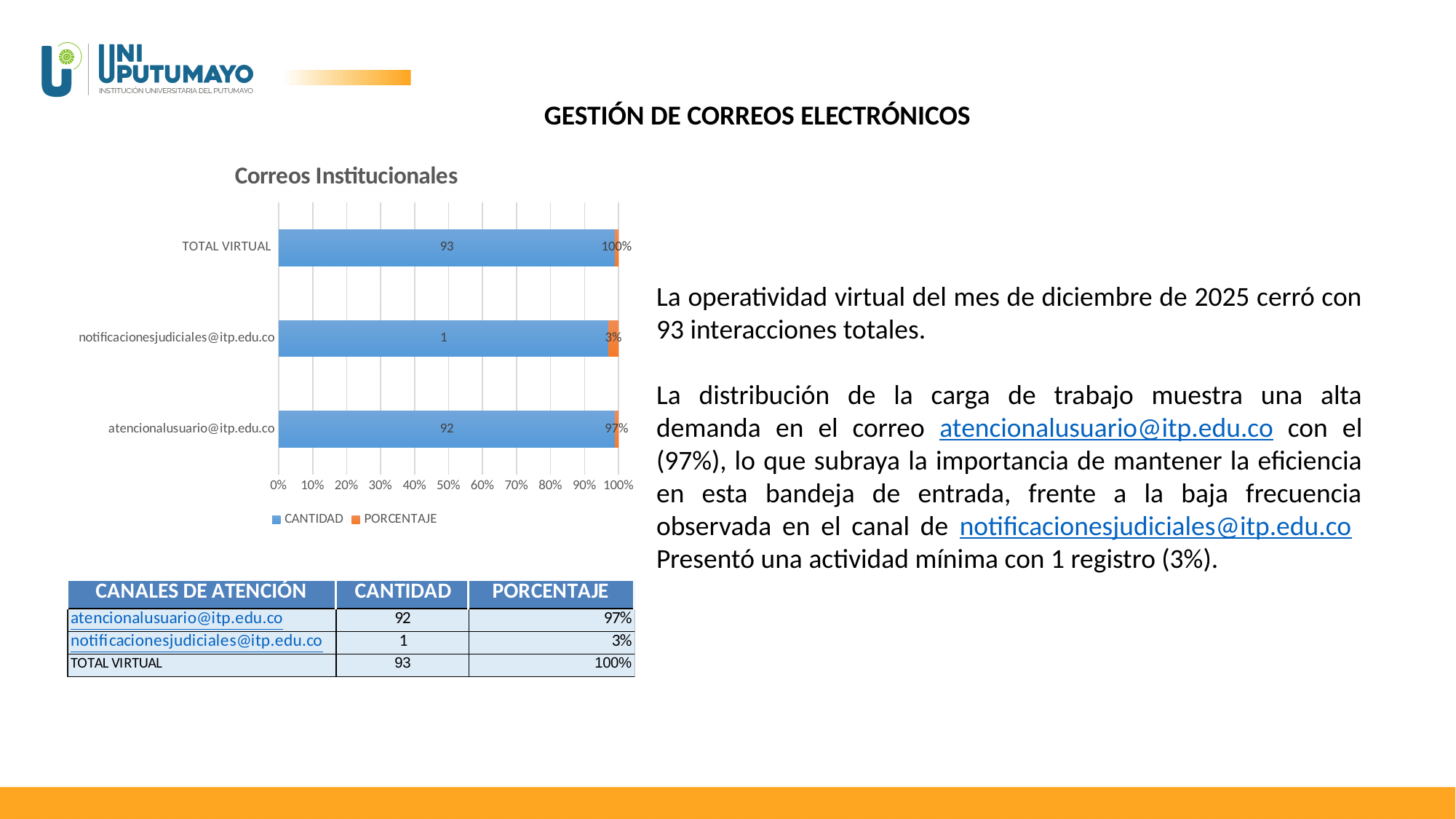
How many series does the legend of the "Correos Institucionales" chart list? 2 In the "Correos Institucionales" chart, which has a larger CANTIDAD value: atencionalusuario@itp.edu.co or notificacionesjudiciales@itp.edu.co? atencionalusuario@itp.edu.co What type of chart is shown under the title "Correos Institucionales"? bar chart In the "Correos Institucionales" chart, which category has the highest CANTIDAD value? TOTAL VIRTUAL In the "Correos Institucionales" chart, what is the PORCENTAJE value for notificacionesjudiciales@itp.edu.co? 3% In the "Correos Institucionales" chart, what is the PORCENTAJE value for atencionalusuario@itp.edu.co? 97% How many categories are shown on the vertical axis of the "Correos Institucionales" chart? 3 In the "Correos Institucionales" chart, what is the CANTIDAD value for atencionalusuario@itp.edu.co? 92 What are the two series named in the legend of the "Correos Institucionales" chart? CANTIDAD and PORCENTAJE In the "Correos Institucionales" chart, what is the difference between the CANTIDAD values for atencionalusuario@itp.edu.co and notificacionesjudiciales@itp.edu.co? 91 In the "Correos Institucionales" chart, which category has the lowest CANTIDAD value? notificacionesjudiciales@itp.edu.co In the "Correos Institucionales" chart, what is the CANTIDAD value for TOTAL VIRTUAL? 93